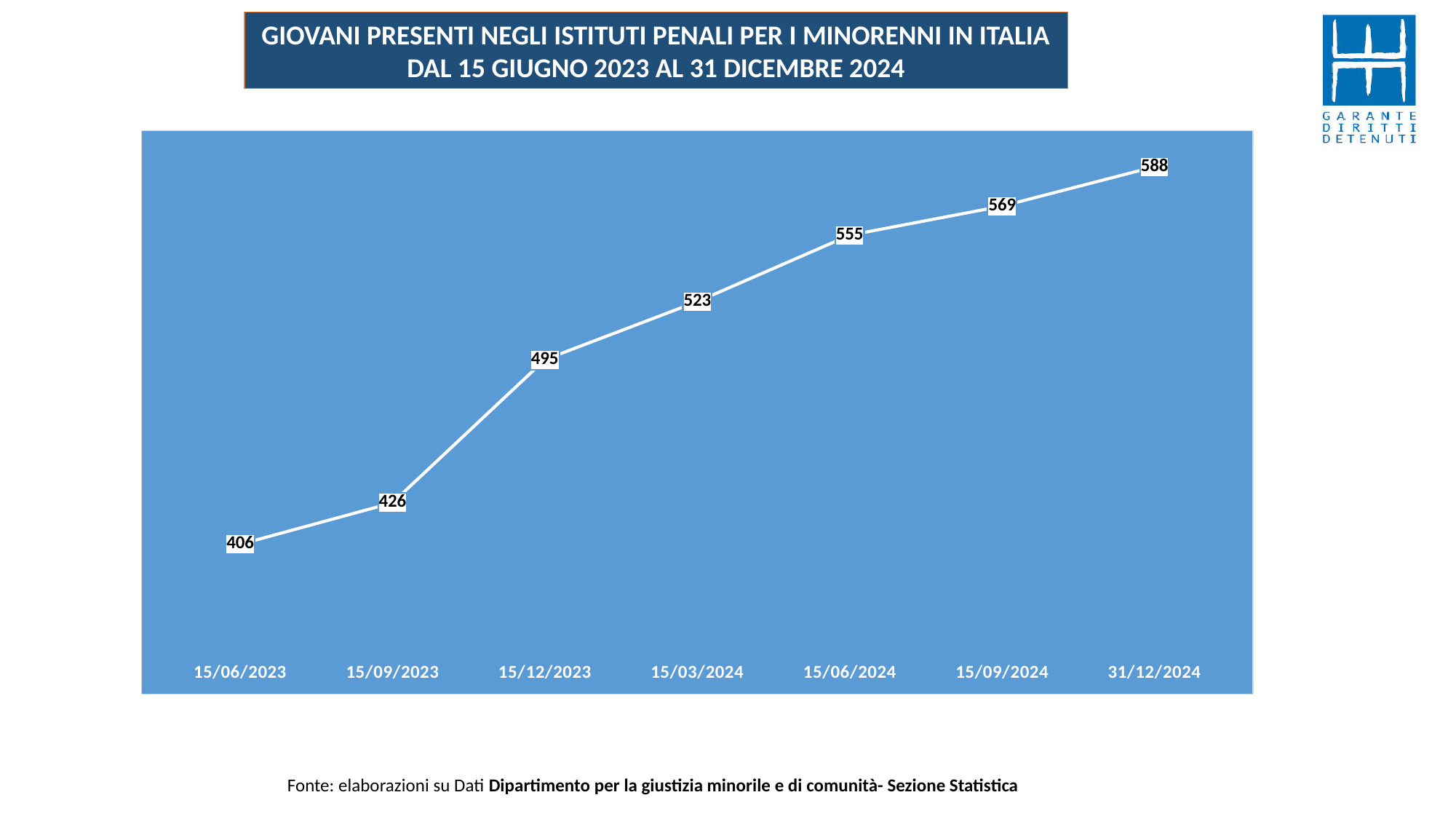
What is the value for 15/12/2023? 495 How many data points are plotted on the chart? 7 What is the value for 31/12/2024? 588 What kind of chart is shown on the slide? Line chart What is the value for 15/06/2023? 406 What is the source cited below the chart? Dipartimento per la giustizia minorile e di comunità- Sezione Statistica Which date has the lowest value? 15/06/2023 Do the values rise or fall from 15/06/2023 to 31/12/2024? Rise Which date has the highest value? 31/12/2024 Which is larger, the value for 15/03/2024 or the value for 15/06/2024? 15/06/2024 What is the difference between the values for 31/12/2024 and 15/06/2023? 182 What is the difference between the values for 15/12/2023 and 15/09/2023? 69